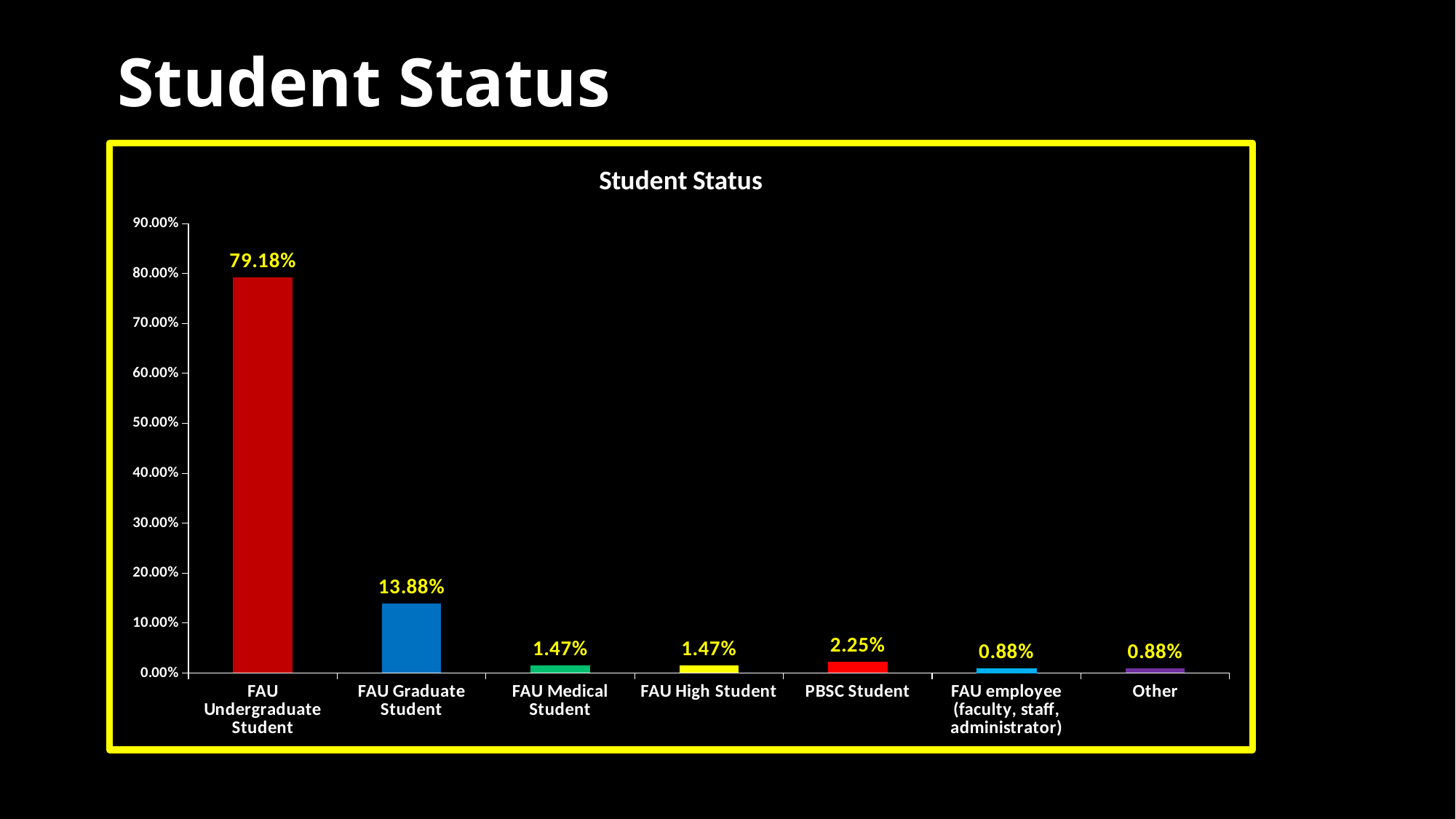
What is the title of the chart? Student Status What is the value for PBSC Student? 2.25% What is the value for FAU Graduate Student? 13.88% What kind of chart is shown? bar chart What is the difference between the values for PBSC Student and FAU Medical Student? 0.78% Is the value for FAU Graduate Student greater or less than 20.00%? less How many categories are shown on the x axis? 7 What is the difference between the values for FAU Undergraduate Student and FAU Graduate Student? 65.30% What is the value for FAU Undergraduate Student? 79.18% What is the value for FAU employee (faculty, staff, administrator)? 0.88% Which is larger, the value for PBSC Student or the value for FAU High Student? PBSC Student Which category has the highest value? FAU Undergraduate Student